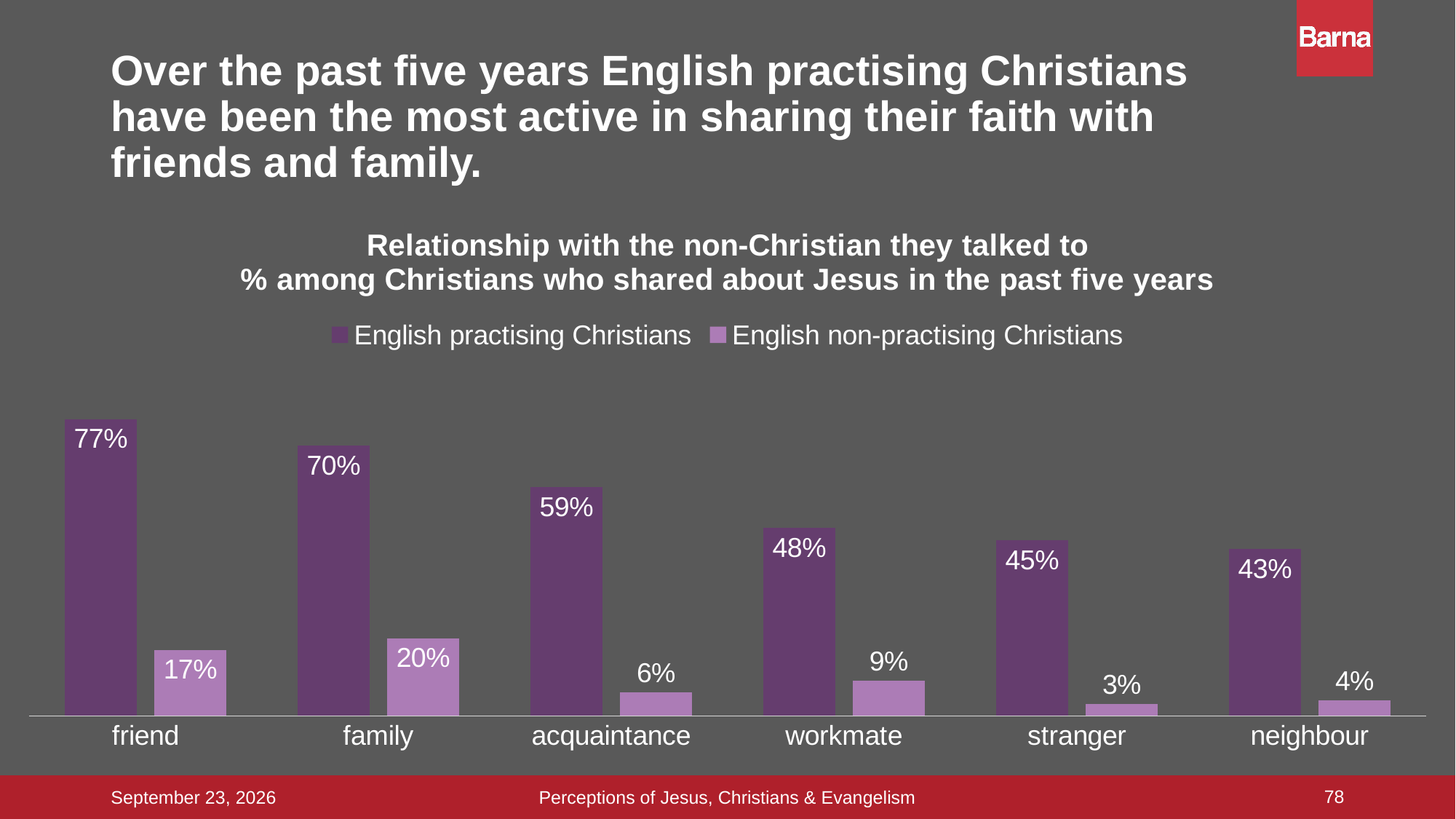
How many series does the legend list? 2 Which relationship category has the lowest value for English non-practising Christians? stranger How many relationship categories are shown on the x axis? 6 What kind of chart is shown on the slide? bar chart What is the difference between the family and neighbour values for English practising Christians? 27% What percentage of English practising Christians shared about Jesus with a friend? 77% What is the value for English practising Christians in the workmate category? 48% For English non-practising Christians, which is larger: the workmate value or the acquaintance value? workmate What is the difference between English practising Christians and English non-practising Christians in the friend category? 60% What percentage of English non-practising Christians shared about Jesus with a family member? 20% Do the values for English practising Christians rise or fall from friend to neighbour along the x axis? fall Which relationship category has the highest value for English practising Christians? friend